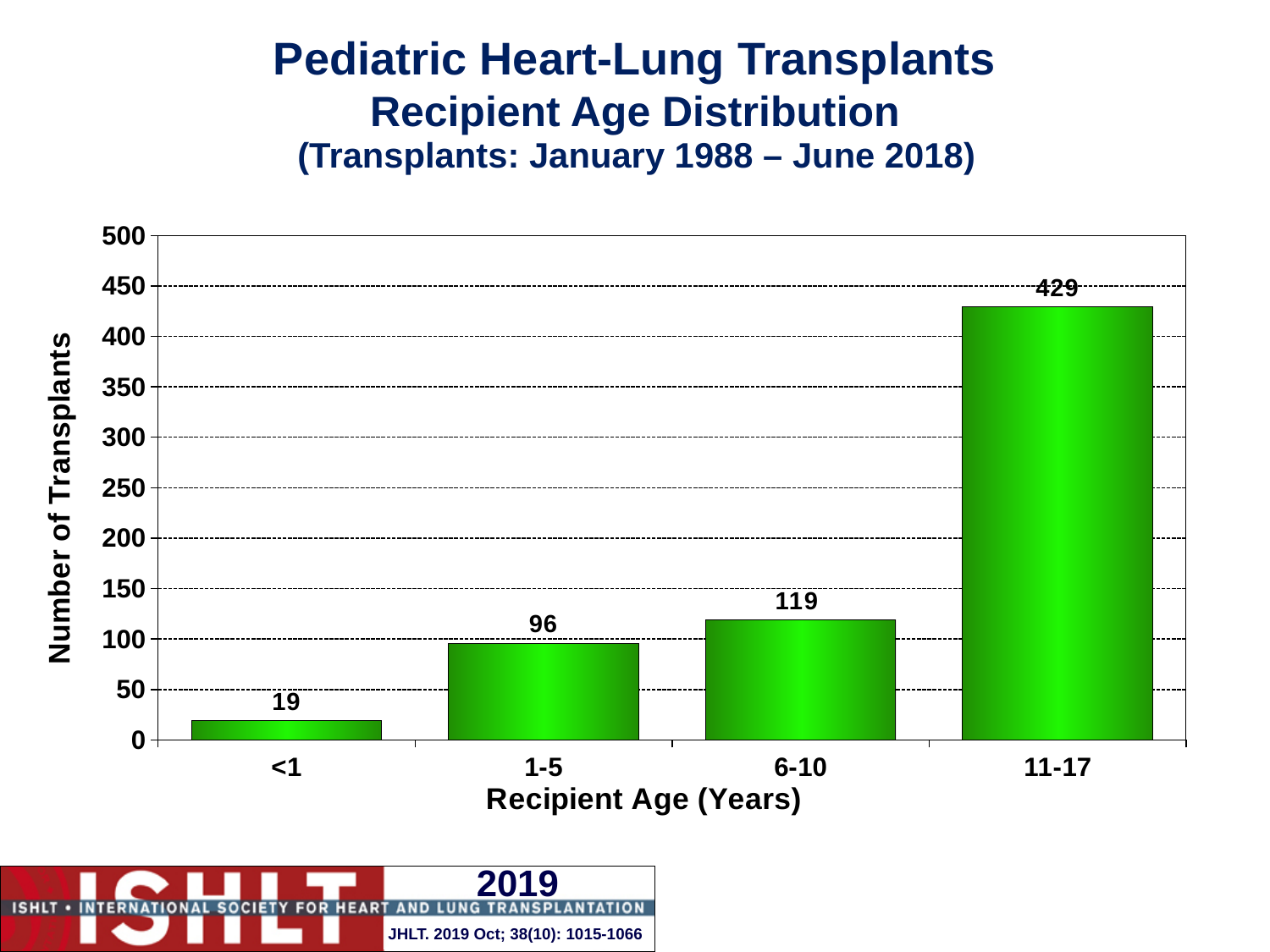
How many recipient age groups are shown on the x axis? 4 What is the label of the y axis? Number of Transplants What is the difference in the number of transplants between the 11-17 and 6-10 age groups? 310 What is the number of transplants for the 1-5 year age group? 96 Which recipient age group has the lowest number of transplants? <1 Which age group has more transplants, 1-5 or 6-10? 6-10 How many pediatric heart-lung transplants were performed in recipients aged 11-17 years? 429 What is the number of transplants for recipients aged <1 year? 19 What is the difference in the number of transplants between the 6-10 and 1-5 age groups? 23 Which recipient age group has the highest number of transplants? 11-17 What is the number of transplants for the 6-10 year age group? 119 What type of chart is shown on the slide? Bar chart